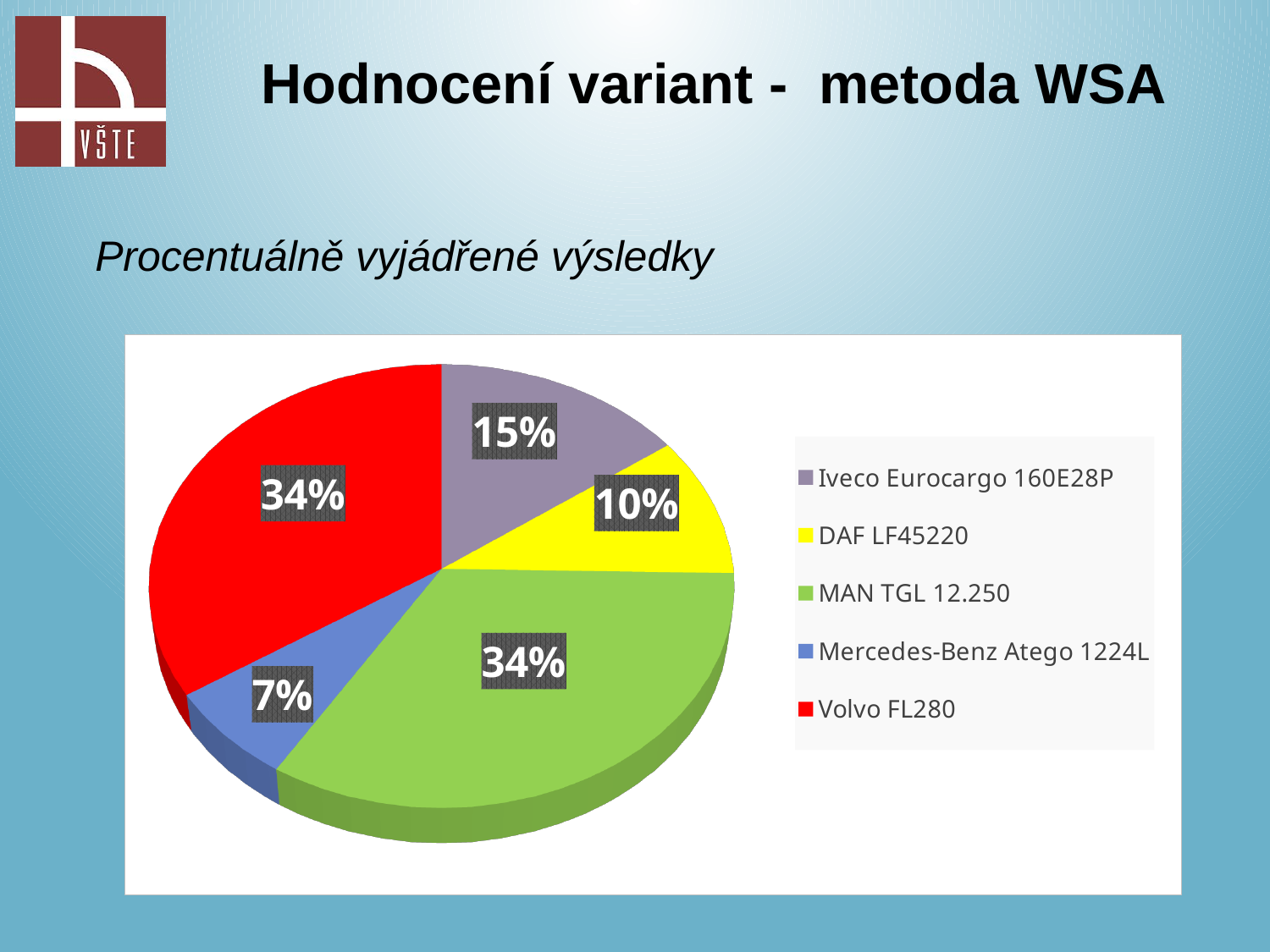
How many categories are shown in the pie chart? 5 Which is larger, the slice for Iveco Eurocargo 160E28P or the slice for DAF LF45220? Iveco Eurocargo 160E28P Which colour represents Volvo FL280 in the legend? Red What is the value for Mercedes-Benz Atego 1224L? 7% What share of the pie does Volvo FL280 have? 34% What percentage is shown for DAF LF45220? 10% What is the difference in percentage points between Volvo FL280 and Mercedes-Benz Atego 1224L? 27 percentage points What kind of chart is shown on the slide? Pie chart Which category has the smallest slice of the pie? Mercedes-Benz Atego 1224L What is the difference in percentage points between Iveco Eurocargo 160E28P and DAF LF45220? 5 percentage points What share does MAN TGL 12.250 have in the pie chart? 34% What is the value shown for Iveco Eurocargo 160E28P? 15%